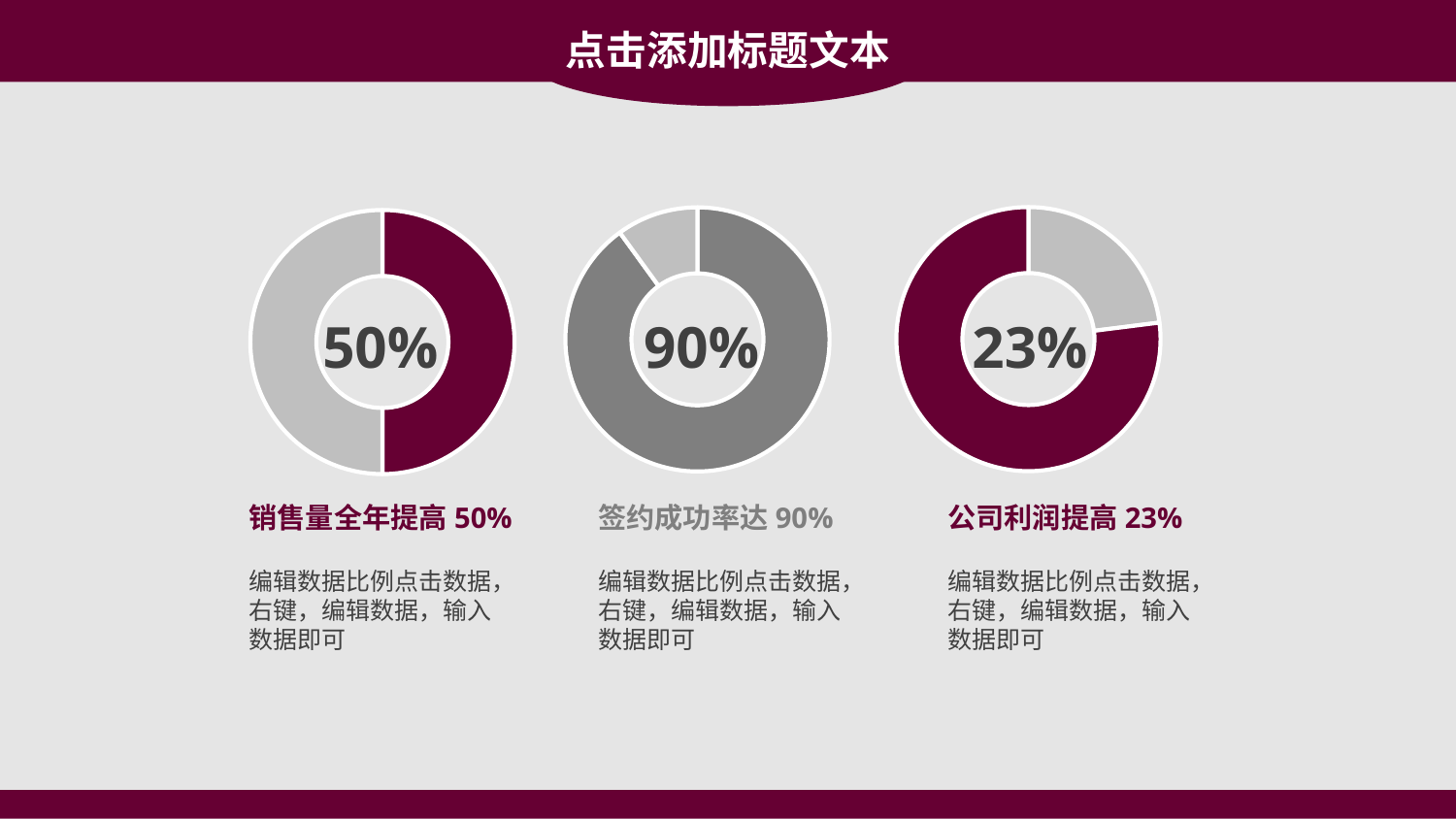
Which of the three donut charts shows the highest percentage? The middle chart (90%) Is the percentage in the left chart larger or smaller than the percentage in the right chart? Larger How many donut charts are on the slide? 3 Which of the three donut charts shows the lowest percentage? The right chart (23%) What percentage is shown in the centre of the middle donut chart? 90% What kind of charts are shown on the slide? Donut charts What caption is written under the right donut chart? 公司利润提高 23% What is the difference between the percentage in the middle chart and the percentage in the left chart? 40% What percentage is shown in the centre of the left donut chart? 50% In the middle donut chart, what share does the light grey slice represent? 10% What colour is the 50% slice in the left donut chart? Maroon What percentage is shown in the centre of the right donut chart? 23%